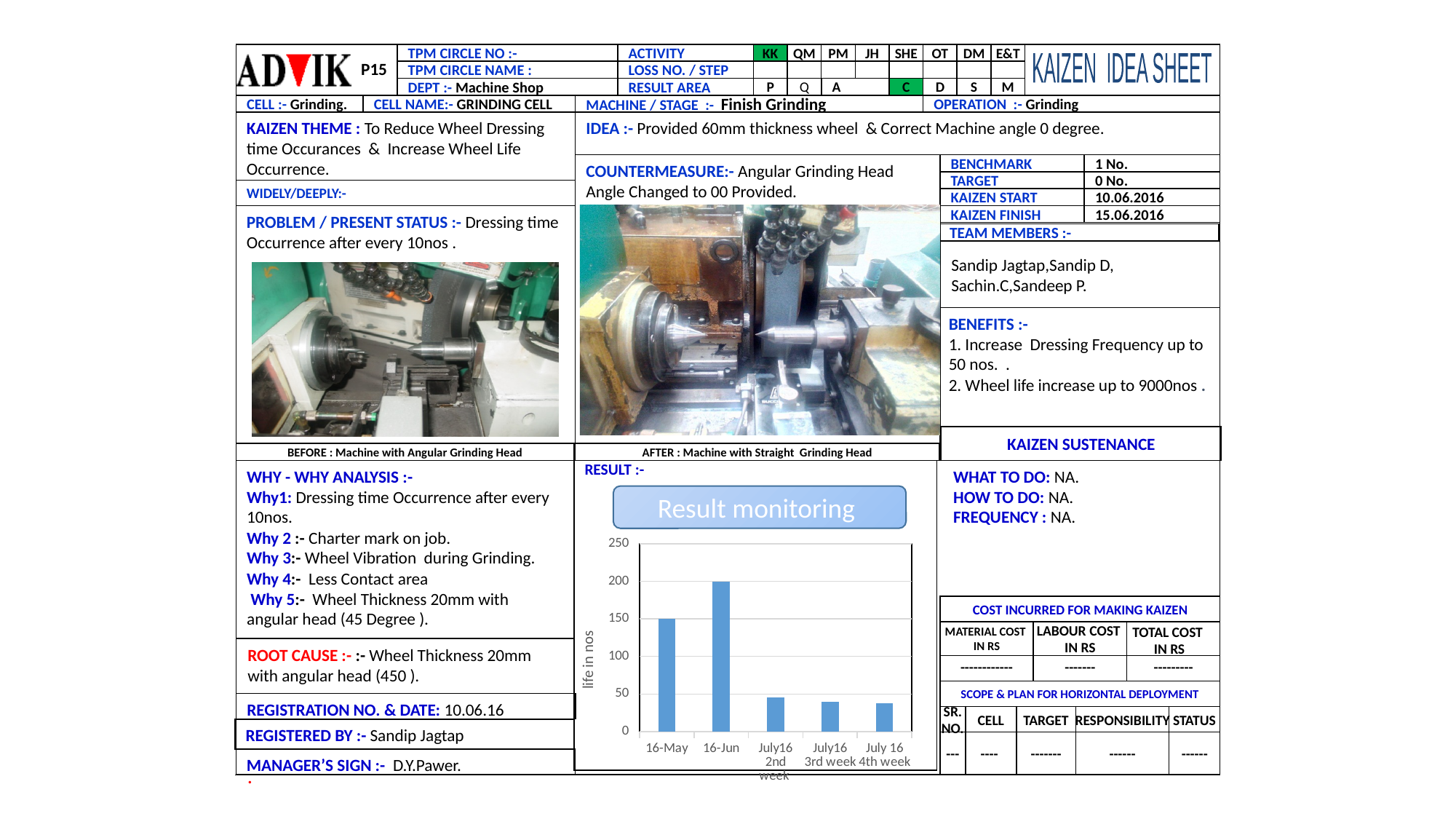
What is the label on the vertical axis of the Result monitoring chart? life in nos In the Result monitoring chart, is the value for 16-Jun greater or less than 150? greater In the Result monitoring chart, is the value for July 16 4th week greater or less than 100? less In the Result monitoring chart, is the value for 16-May greater or less than 100? greater In the Result monitoring chart, which is larger: the value for 16-May or the value for 16-Jun? 16-Jun What type of chart is shown under RESULT on the slide? bar chart Which category has the highest value in the Result monitoring chart? 16-Jun How many categories are plotted on the x axis of the Result monitoring chart? 5 In the Result monitoring chart, which is larger: the value for 16-May or the value for July16 3rd week? 16-May What is the title of the chart on the slide? Result monitoring In the Result monitoring chart, do the values rise or fall from 16-Jun to July 16 4th week? fall